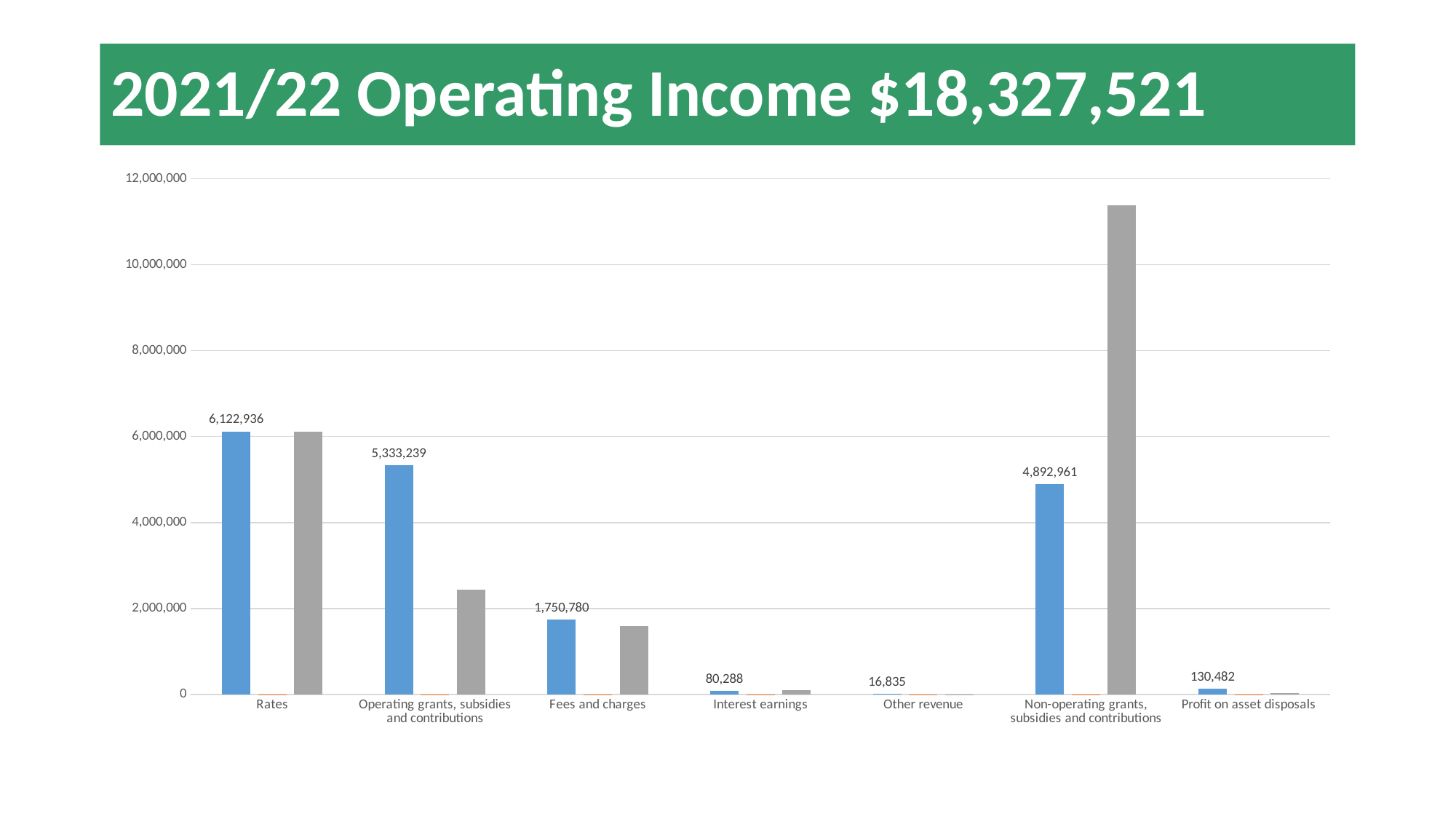
What is the title of the slide? 2021/22 Operating Income $18,327,521 What is the difference between the labelled values for Rates and Operating grants, subsidies and contributions? 789,697 What is the labelled value for Profit on asset disposals? 130,482 Is the value of the grey bar for Non-operating grants, subsidies and contributions greater or less than 10,000,000? greater Which category has the lowest labelled value? Other revenue Which category has the highest labelled value? Rates What is the labelled value for Rates? 6,122,936 What is the labelled value for Operating grants, subsidies and contributions? 5,333,239 What is the labelled value for Non-operating grants, subsidies and contributions? 4,892,961 Which has the larger labelled value: Operating grants, subsidies and contributions or Non-operating grants, subsidies and contributions? Operating grants, subsidies and contributions What is the labelled value for Fees and charges? 1,750,780 How many categories are shown on the x axis? 7